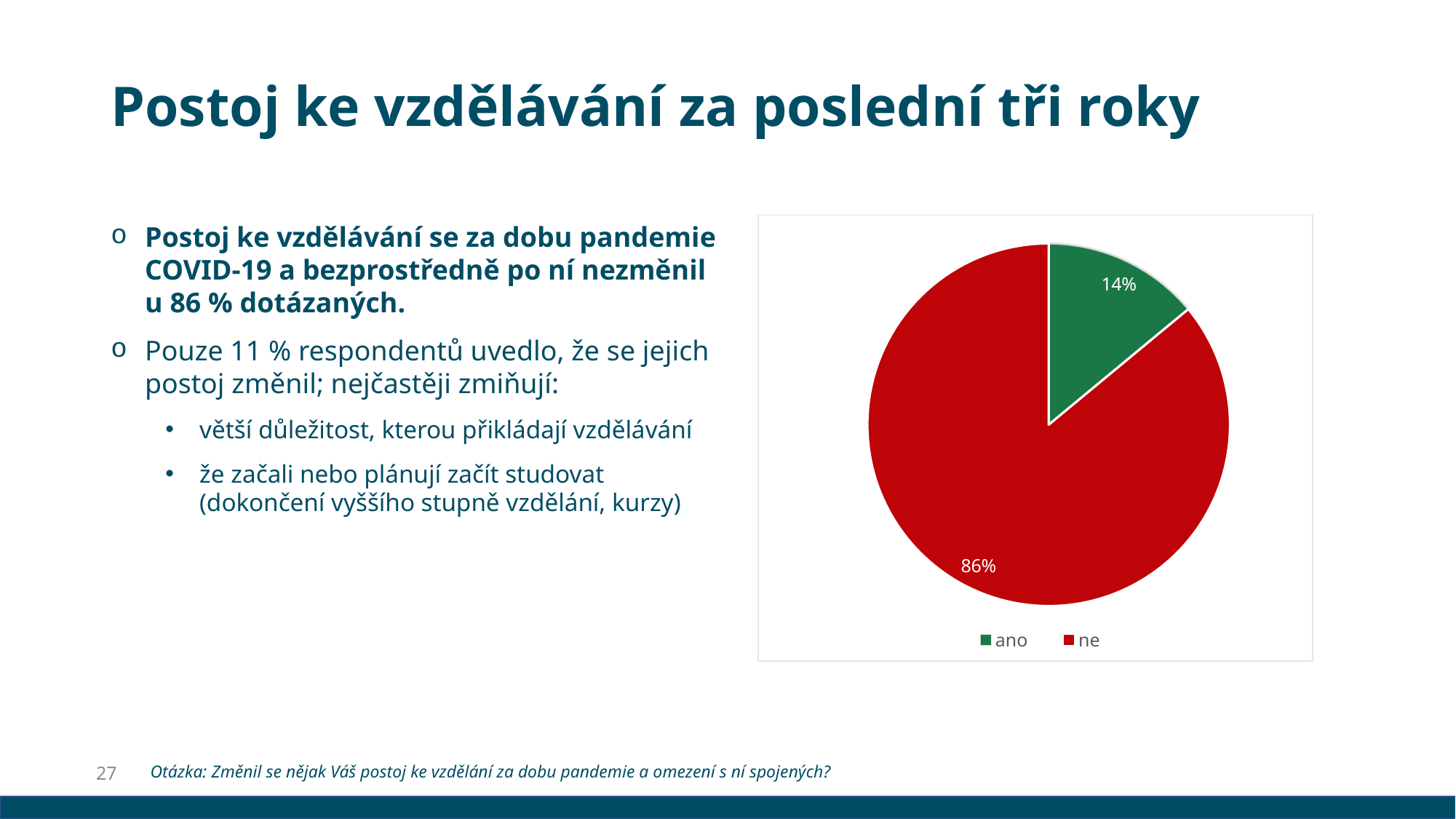
Which slice of the pie is the smallest? ano Which slice is larger, "ano" or "ne"? ne How many entries does the legend list? 2 What share of the pie does the "ne" slice represent? 86% How many slices does the pie chart have? 2 Which slice of the pie is the largest? ne What colour is the "ano" slice? green What is the difference in percentage points between the "ne" and "ano" slices? 72 What colour is the "ne" slice? red What share of the pie does the "ano" slice represent? 14% What kind of chart is shown on the slide? pie chart